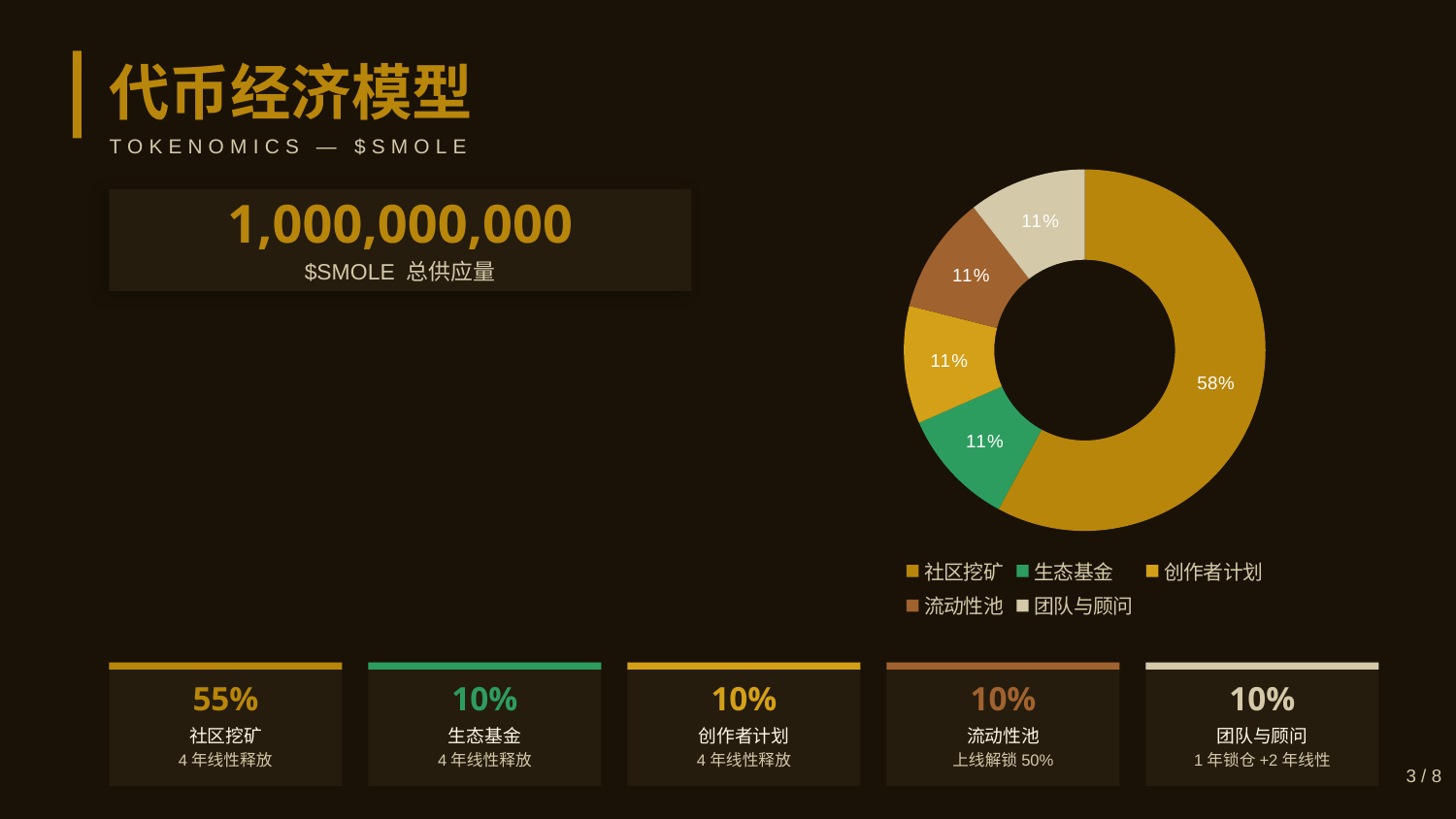
How many entries does the pie chart's legend list? 5 Which legend entry in the pie chart is shown in brown? 流动性池 In the pie chart, which is larger: the 社区挖矿 slice or the 创作者计划 slice? 社区挖矿 What kind of chart is shown on the slide? Pie chart (donut) Which legend entry in the pie chart is shown in green? 生态基金 Which category has the largest slice in the pie chart? 社区挖矿 How many slices does the pie chart have? 5 What percentage does the pie chart show for 团队与顾问? 11% What share of the pie chart does the 创作者计划 slice represent? 11% What percentage does the pie chart show for 社区挖矿? 58% What percentage does the pie chart show for 生态基金? 11% What is the difference between the 社区挖矿 slice and the 流动性池 slice in the pie chart? 47%